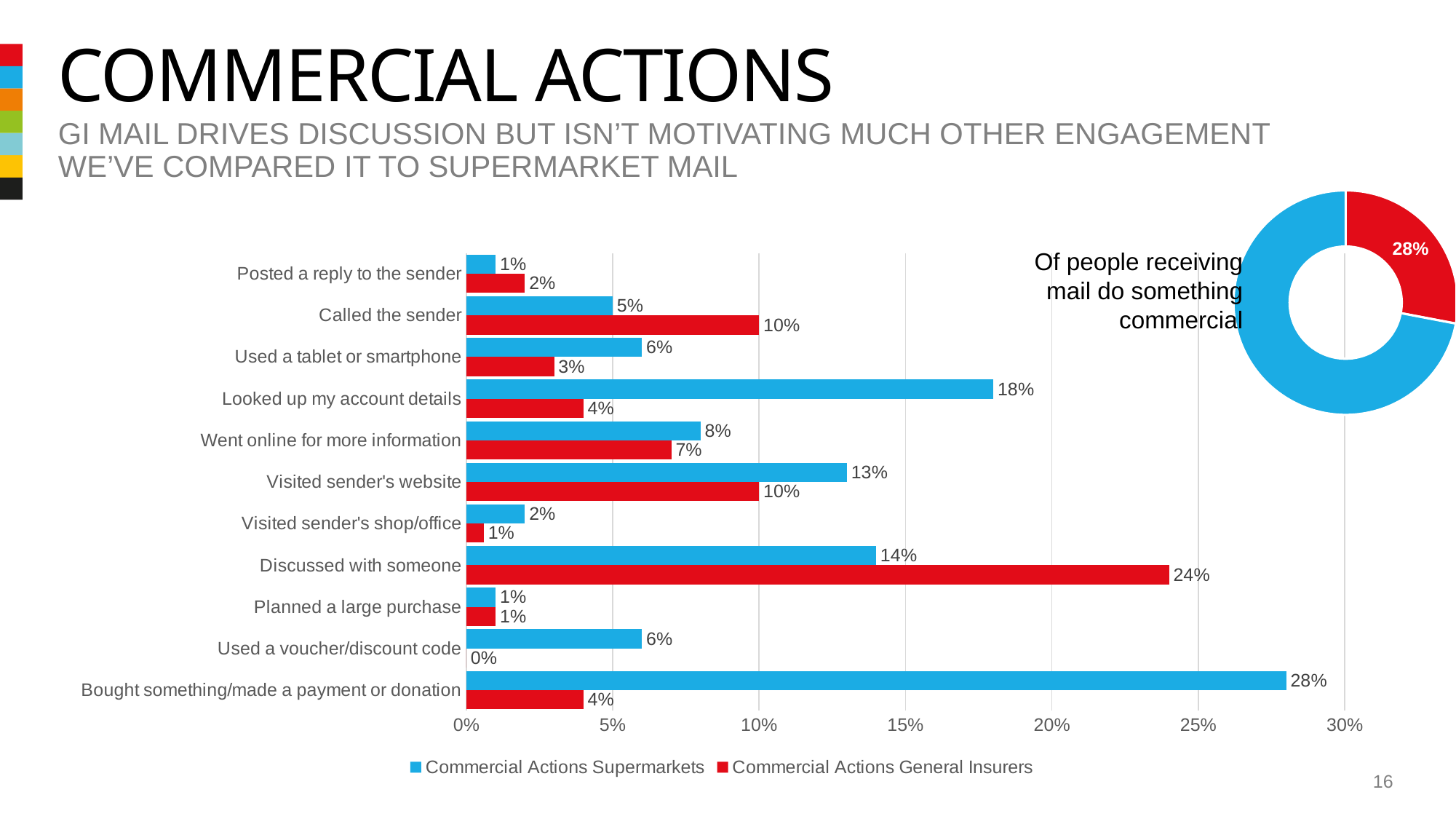
What kind of chart is the chart on the left of the slide? Bar chart In the bar chart, how many series does the legend list? 2 In the bar chart, what is the difference between the General Insurers and Supermarkets values for 'Discussed with someone'? 10% In the bar chart, which category has the lowest value for Commercial Actions General Insurers? Used a voucher/discount code In the bar chart, which is larger for 'Called the sender': Commercial Actions Supermarkets or Commercial Actions General Insurers? Commercial Actions General Insurers In the bar chart, what is the value for Commercial Actions General Insurers for 'Used a voucher/discount code'? 0% In the donut chart on the right, what share is shown for the red slice? 28% In the bar chart, which category has the highest value for Commercial Actions Supermarkets? Bought something/made a payment or donation In the bar chart, what is the value for Commercial Actions Supermarkets for 'Looked up my account details'? 18% In the bar chart, which series is shown in red according to the legend? Commercial Actions General Insurers In the bar chart, how many categories are shown on the vertical axis? 11 In the bar chart, what is the value for Commercial Actions General Insurers for 'Discussed with someone'? 24%